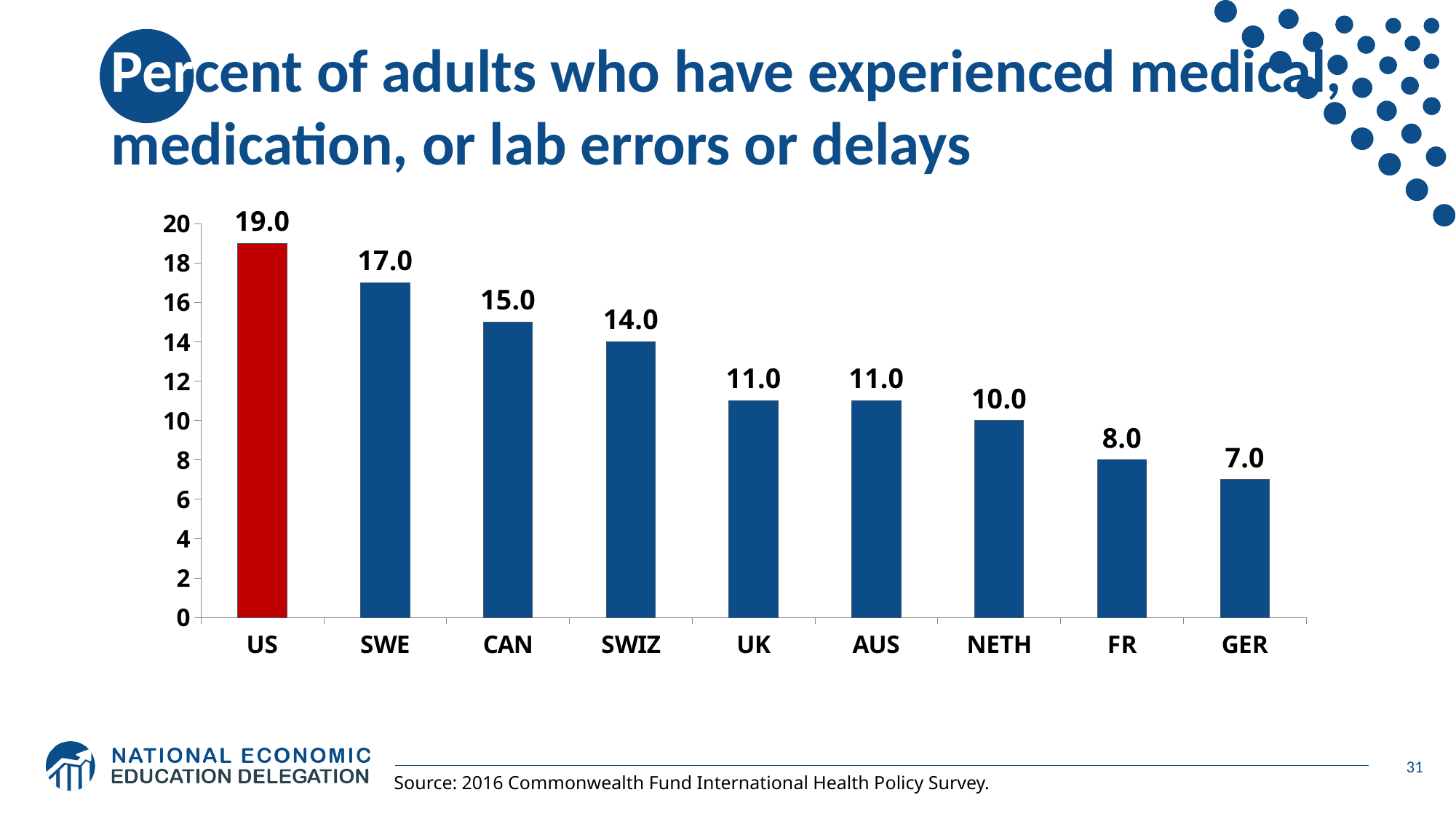
Which country has the lowest value? GER What is the value for the US? 19.0 Which country has the highest value? US Is the value for CAN greater or less than 10? greater What kind of chart is shown on the slide? bar chart Which bar is coloured red rather than blue? US What is the value for NETH? 10.0 What is the difference between the values for CAN and SWIZ? 1.0 What is the value for SWE? 17.0 What is the difference between the values for the US and GER? 12.0 How many countries are shown on the chart? 9 Which is larger, the value for SWE or the value for FR? SWE